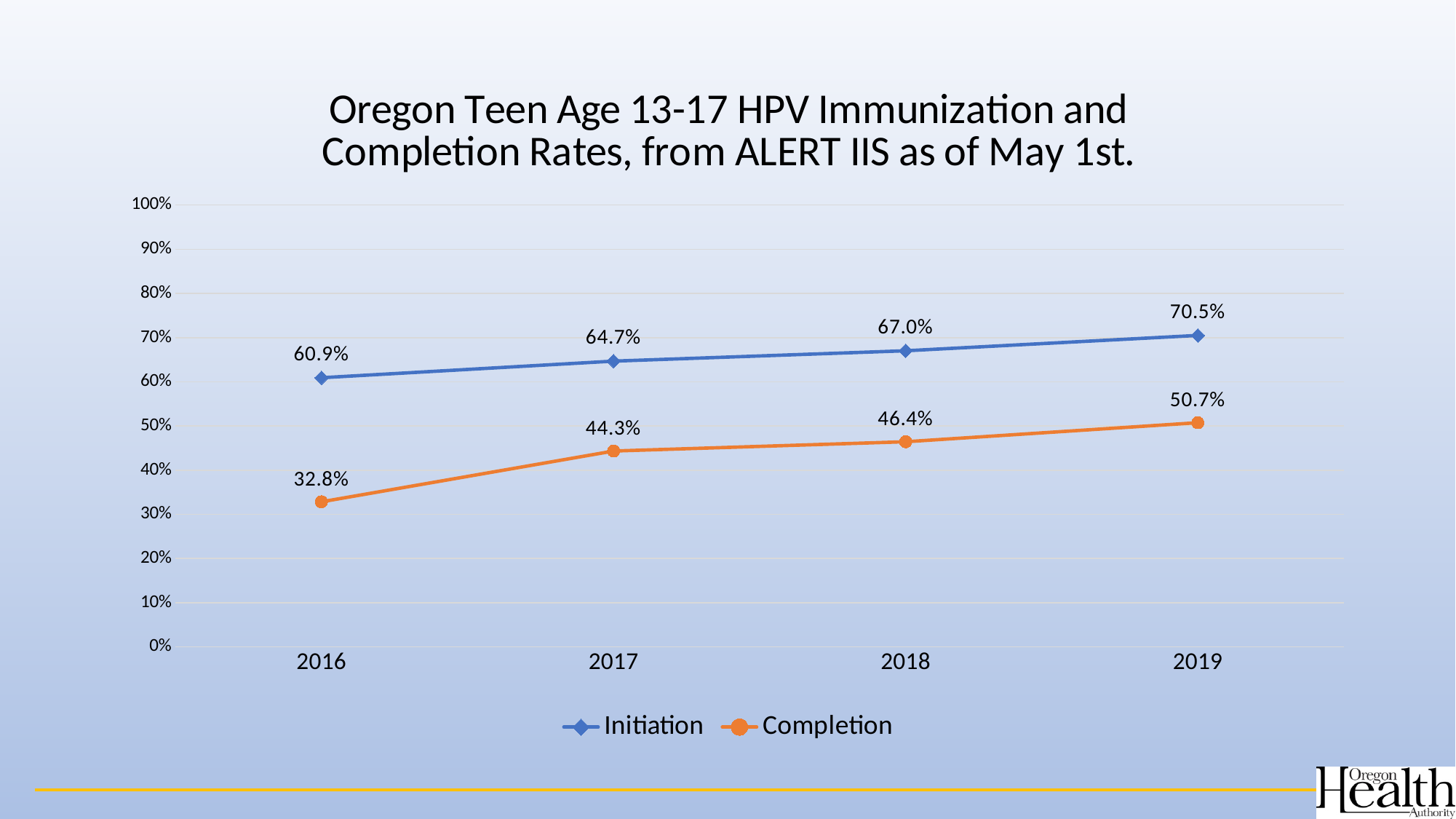
What is the Completion rate for 2017? 44.3% What is the difference between the Initiation and Completion rates in 2018? 20.6% Which is larger, the Initiation rate in 2017 or the Completion rate in 2019? Initiation rate in 2017 What kind of chart is shown on the slide? Line chart What is the Initiation rate for 2016? 60.9% How many series does the legend list? 2 By how much did the Completion rate increase from 2016 to 2019? 17.9% What is the Completion rate for 2019? 50.7% How many years are shown on the x axis? 4 Does the Completion rate rise or fall from 2016 to 2019? Rise In which year is the Initiation rate highest? 2019 In which year is the Completion rate lowest? 2016